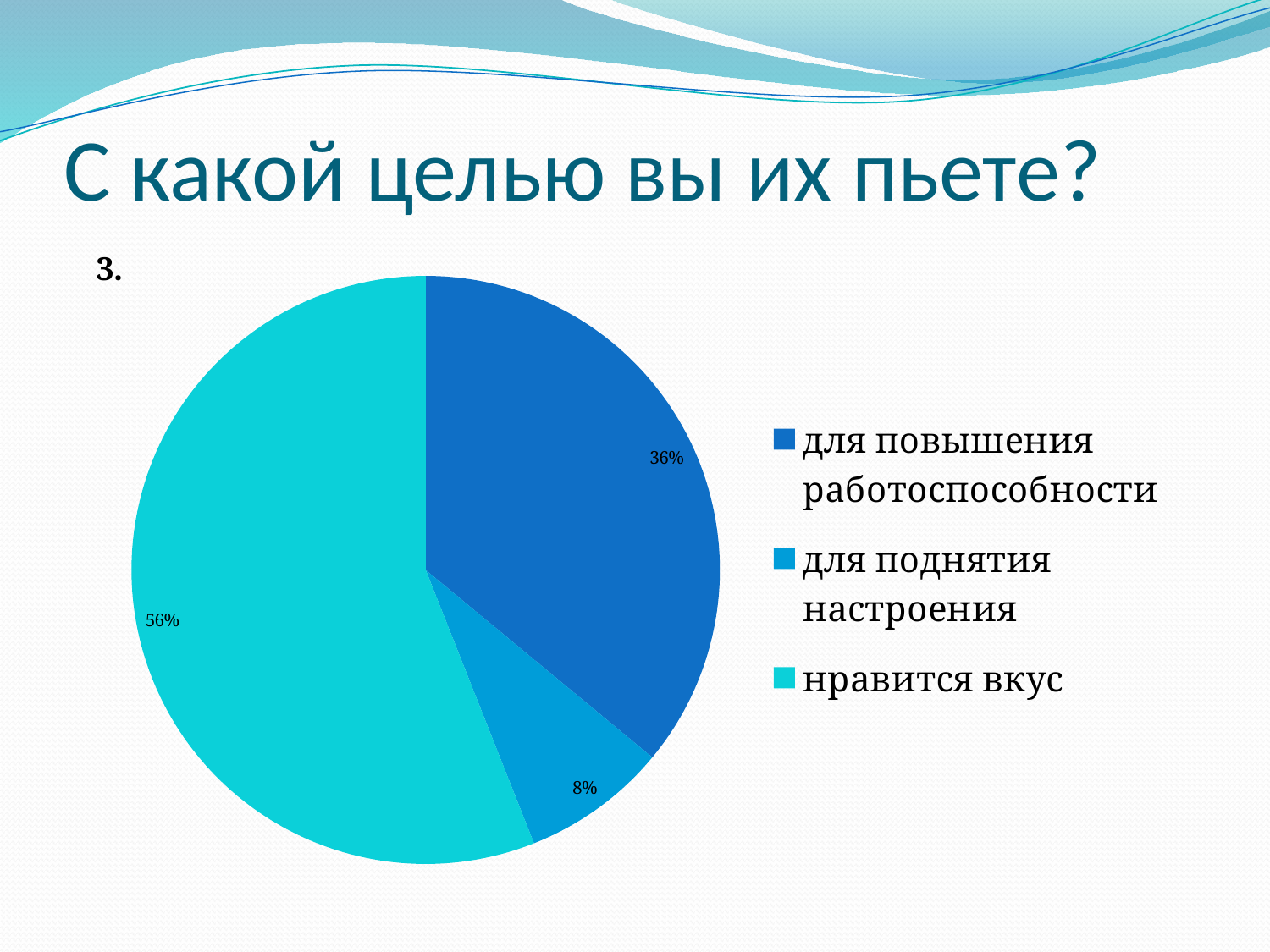
Which category has the largest slice of the pie? нравится вкус What is the difference in percentage points between "нравится вкус" and "для повышения работоспособности"? 20 What is the difference in percentage points between "для повышения работоспособности" and "для поднятия настроения"? 28 What is the title of the slide containing the chart? С какой целью вы их пьете? What share of the pie is labelled "нравится вкус"? 56% How many categories does the pie chart show? 3 What kind of chart is shown on the slide? pie chart Which category has the smallest slice of the pie? для поднятия настроения What share of the pie is labelled "для повышения работоспособности"? 36% Which legend entry is shown in the darkest blue colour? для повышения работоспособности Which is larger: the slice for "для повышения работоспособности" or the slice for "для поднятия настроения"? для повышения работоспособности What share of the pie is labelled "для поднятия настроения"? 8%